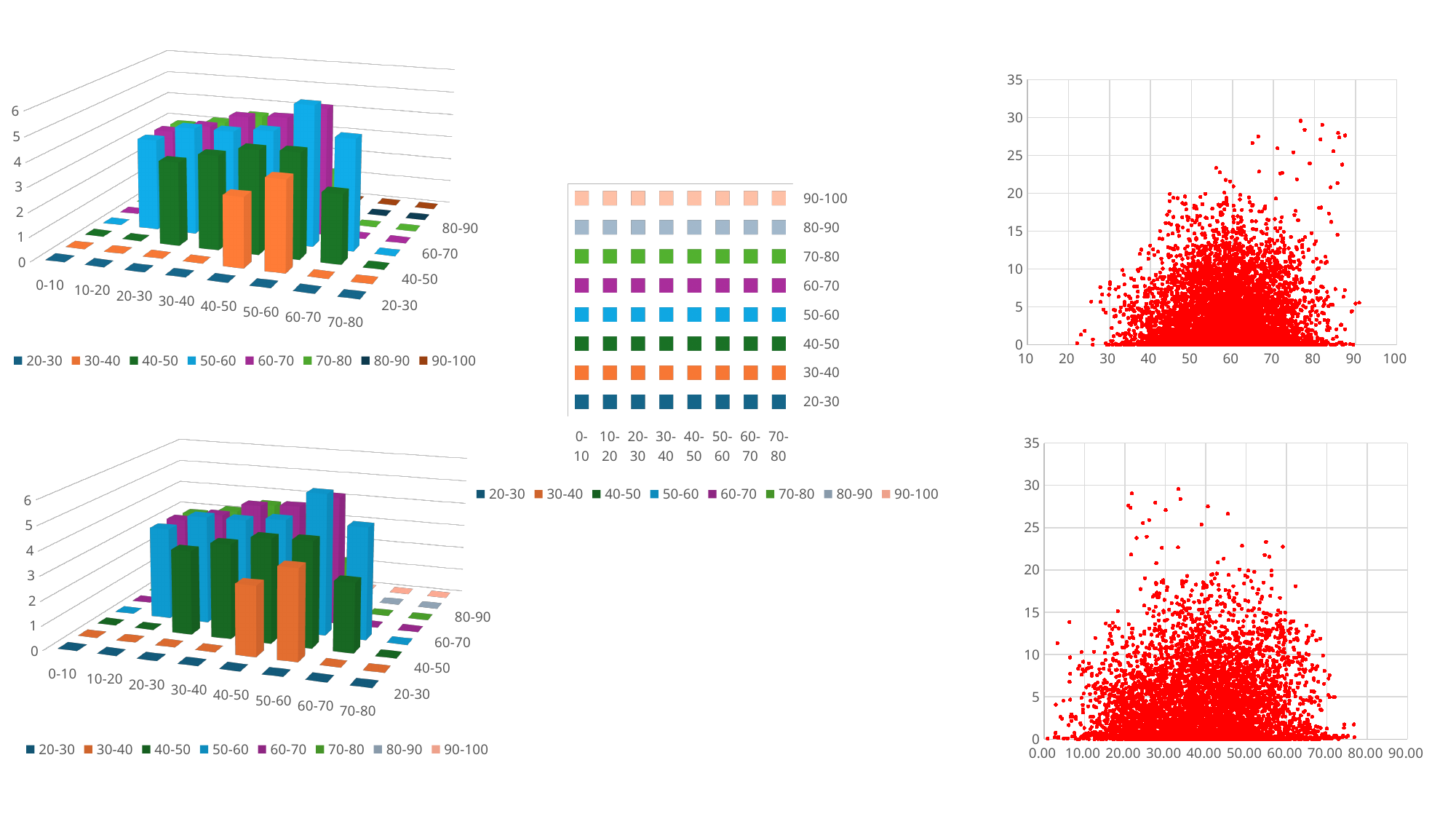
How many categories are shown along the front axis of the bottom-left chart (0-10 through 70-80)? 8 How many series does the legend of the bottom-left chart list? 8 What kind of chart is the top-right chart on the slide? scatter chart In the bottom-right scatter chart, is the highest plotted point greater or less than 25 on the vertical axis? greater How many series does the legend of the top-left chart list? 8 How many series does the legend of the middle chart list? 8 How many categories are shown along the front axis of the top-left chart (0-10 through 70-80)? 8 In the top-right scatter chart, is the highest plotted point greater or less than 25 on the vertical axis? greater What is the last series listed in the legend of the bottom-left chart? 90-100 In the top-right scatter chart, what colour are the plotted points? red What kind of chart is the top-left chart on the slide? bar chart What kind of chart is the bottom-right chart on the slide? scatter chart